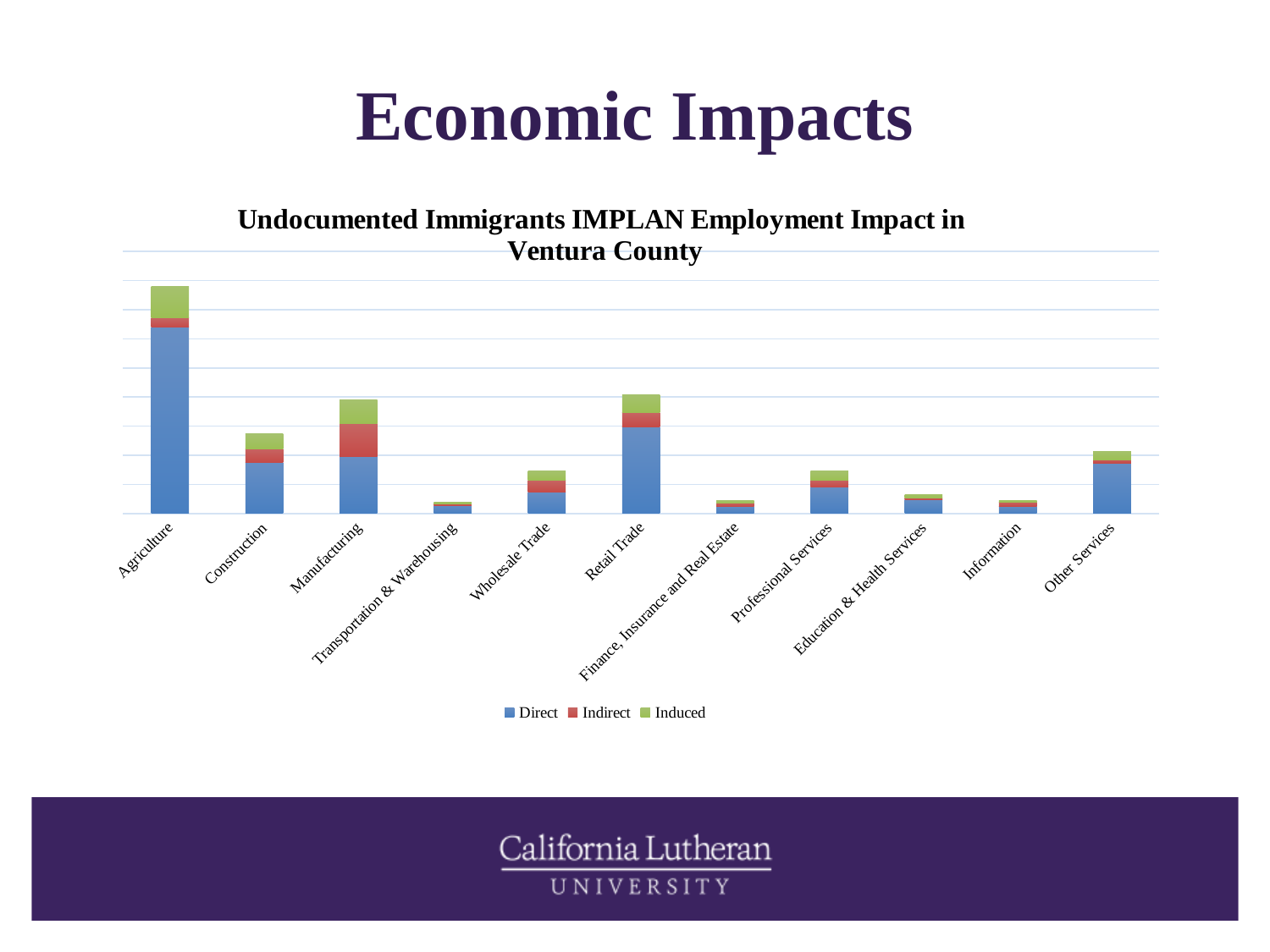
What are the three series named in the legend? Direct, Indirect, Induced Which industry has the largest Direct employment impact? Agriculture Which has a larger total employment impact, Retail Trade or Manufacturing? Retail Trade Which industry has the second highest total employment impact? Retail Trade How many series does the legend list? 3 Which industry has the highest total employment impact? Agriculture What kind of chart is shown on the slide? Stacked bar chart Which has a larger Indirect employment impact, Manufacturing or Construction? Manufacturing How many industry categories are shown on the x axis? 11 Which has a larger total employment impact, Construction or Wholesale Trade? Construction What is the title of the chart? Undocumented Immigrants IMPLAN Employment Impact in Ventura County